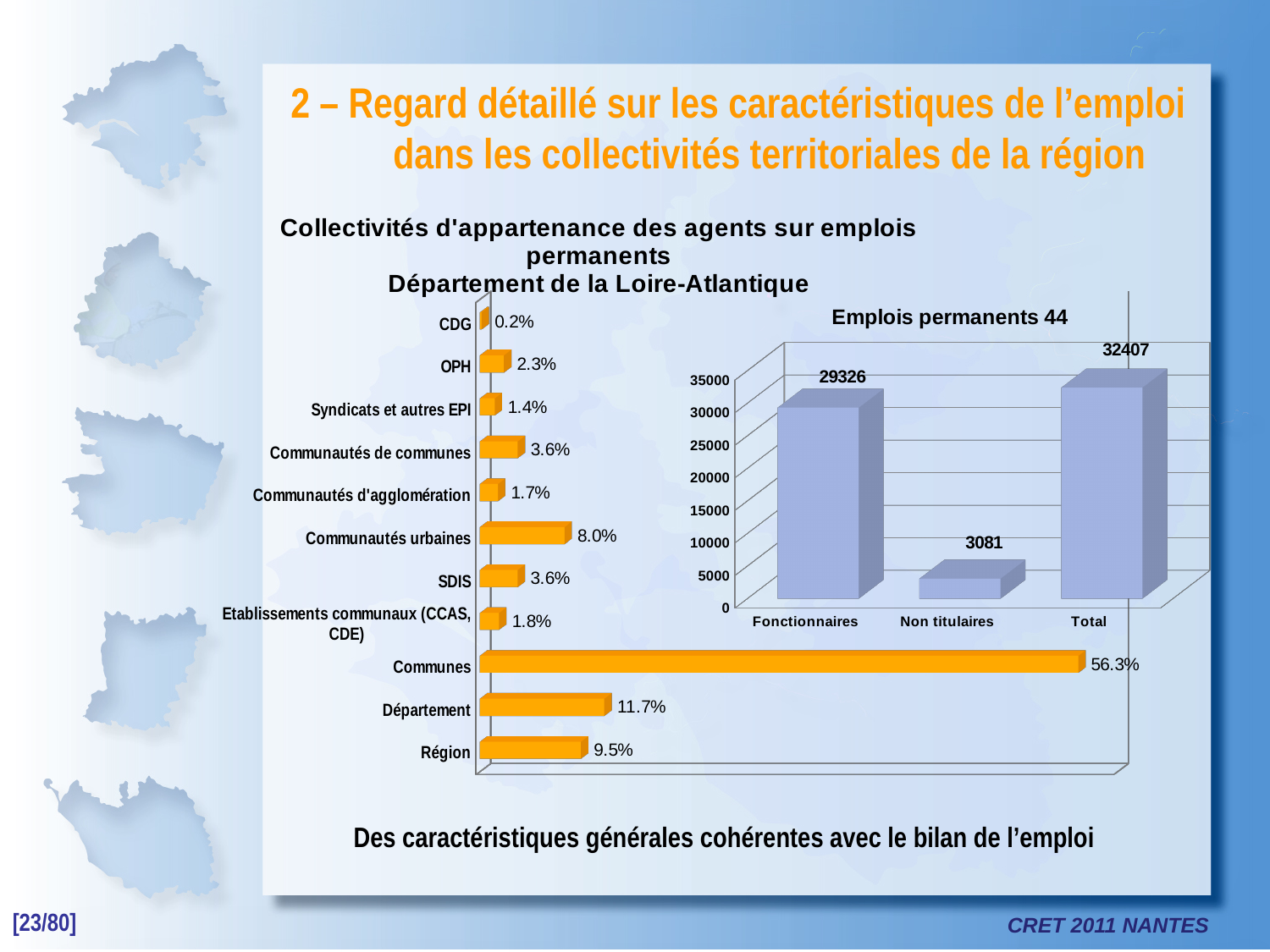
In the chart 'Collectivités d'appartenance des agents sur emplois permanents', which category has the lowest value? CDG In the chart 'Collectivités d'appartenance des agents sur emplois permanents', what is the value for Communes? 56.3% In the chart 'Collectivités d'appartenance des agents sur emplois permanents', which category has the highest value? Communes In the chart 'Emplois permanents 44', what is the value for Non titulaires? 3081 In the chart 'Collectivités d'appartenance des agents sur emplois permanents', what is the difference between Département and Région? 2.2% In the chart 'Collectivités d'appartenance des agents sur emplois permanents', what is the value for Communautés urbaines? 8.0% In the chart 'Emplois permanents 44', what is the value for Fonctionnaires? 29326 In the chart 'Collectivités d'appartenance des agents sur emplois permanents', how many categories are shown? 11 In the chart 'Emplois permanents 44', what is the difference between Total and Fonctionnaires? 3081 What kind of chart is 'Emplois permanents 44'? Bar chart In the chart 'Collectivités d'appartenance des agents sur emplois permanents', which is larger, OPH or Syndicats et autres EPI? OPH In the chart 'Emplois permanents 44', how many categories are shown on the x axis? 3